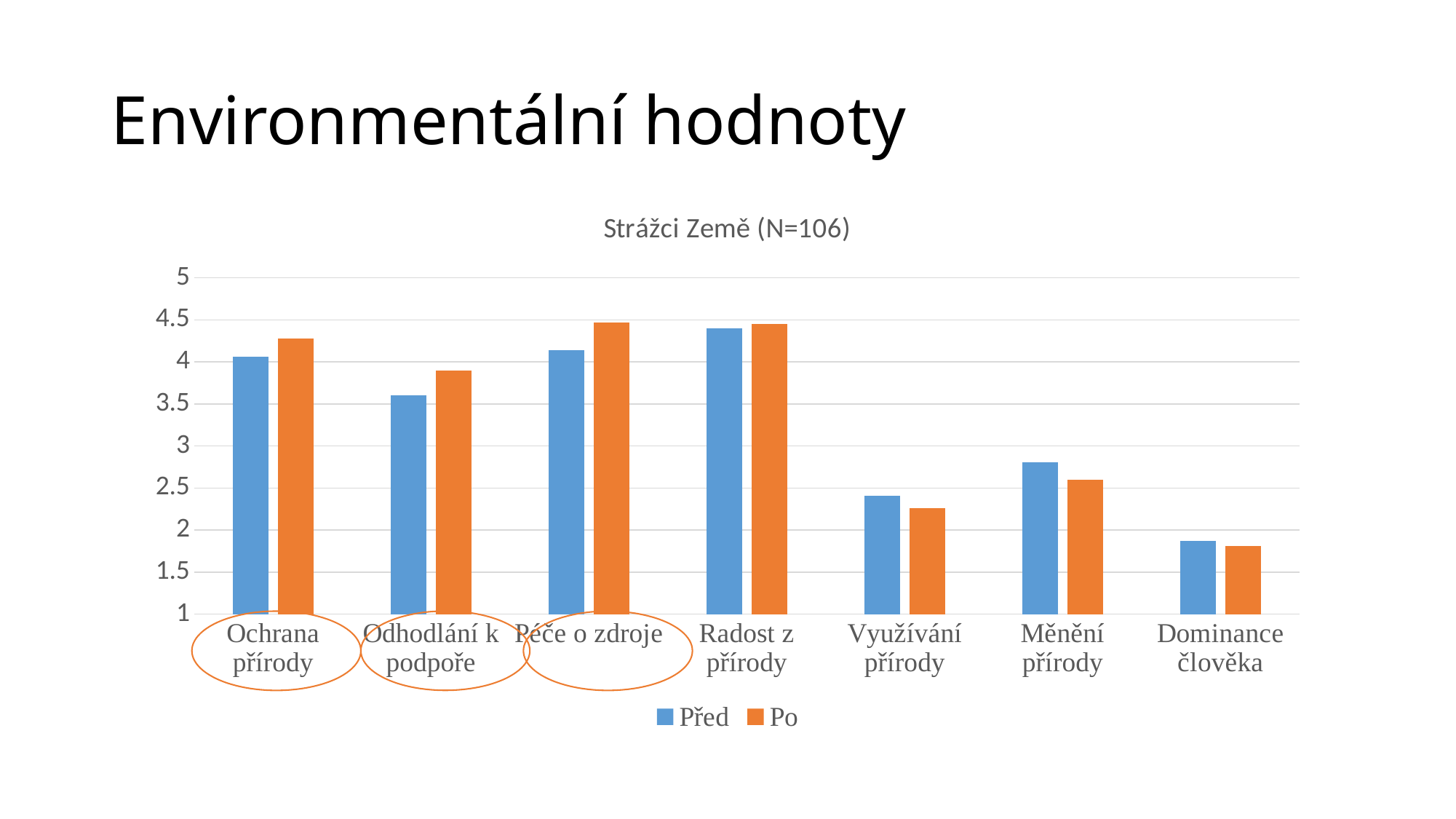
Is the Před value for Dominance člověka greater or less than 2? less How many categories are shown on the x axis? 7 Is the Před value for Odhodlání k podpoře greater or less than 4? less What kind of chart is shown on the slide? bar chart Which category has the lowest value for the Po series? Dominance člověka Is the Po value for Měnění přírody greater or less than 2.5? greater Which category has the highest value for the Před series? Radost z přírody For Měnění přírody, which series has the larger value, Před or Po? Před Which category has the lowest value for the Před series? Dominance člověka How many series does the legend list? 2 For Ochrana přírody, which series has the larger value, Před or Po? Po What is the title of the chart? Strážci Země (N=106)